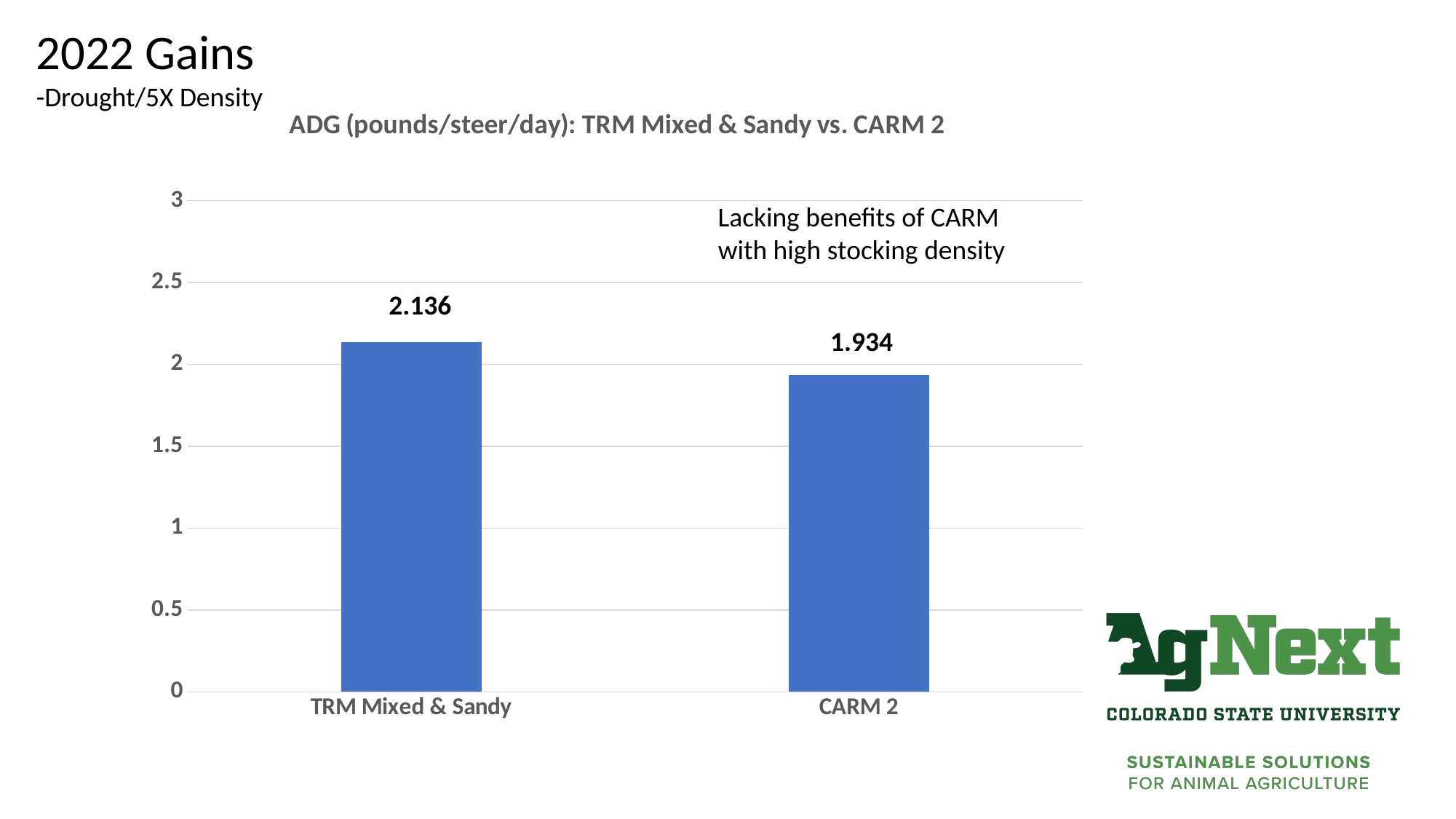
Is the value for TRM Mixed & Sandy greater or less than 2? greater Is the value for CARM 2 greater or less than 2? less What is the ADG value for CARM 2? 1.934 What is the title of the chart? ADG (pounds/steer/day): TRM Mixed & Sandy vs. CARM 2 What is the difference in ADG between TRM Mixed & Sandy and CARM 2? 0.202 Which category has the lower ADG? CARM 2 What is the ADG value for TRM Mixed & Sandy? 2.136 Is the ADG for CARM 2 larger or smaller than the ADG for TRM Mixed & Sandy? smaller How many categories are shown on the chart? 2 What kind of chart is shown on the slide? bar chart Which category has the higher ADG? TRM Mixed & Sandy What is the highest value shown on the y axis? 3